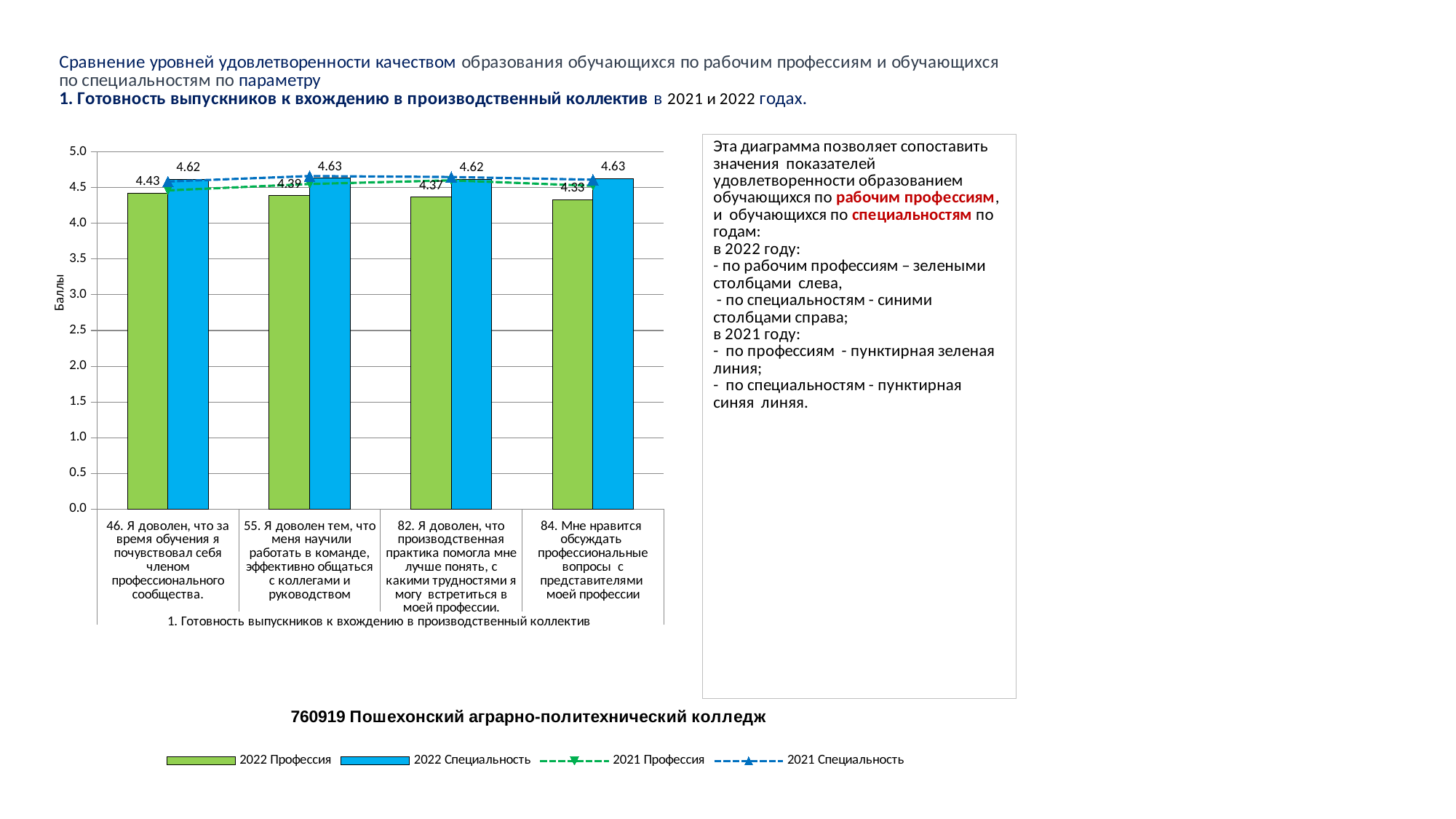
What is the value of the 2022 Специальность bar for category 84 (Мне нравится обсуждать профессиональные вопросы с представителями моей профессии)? 4.63 Which category has the lowest 2022 Профессия value? 84. Мне нравится обсуждать профессиональные вопросы с представителями моей профессии What is the value of the 2022 Профессия bar for category 46 (Я доволен, что за время обучения я почувствовал себя членом профессионального сообщества)? 4.43 Is the 2022 Профессия value for category 84 greater or less than 4.5? less How many series does the chart legend list? 4 What is the difference between the 2022 Специальность and 2022 Профессия values for category 46? 0.19 Which category has the highest 2022 Профессия value? 46. Я доволен, что за время обучения я почувствовал себя членом профессионального сообщества. Do the 2022 Профессия values rise or fall from left to right across the categories? fall How many categories are shown on the x axis of the chart? 4 What is the difference between the 2022 Специальность and 2022 Профессия values for category 84? 0.30 For category 55 (Я доволен тем, что меня научили работать в команде...), which is larger: the 2022 Профессия bar or the 2022 Специальность bar? 2022 Специальность What is the value of the 2022 Профессия bar for category 82 (Я доволен, что производственная практика помогла мне лучше понять...)? 4.37